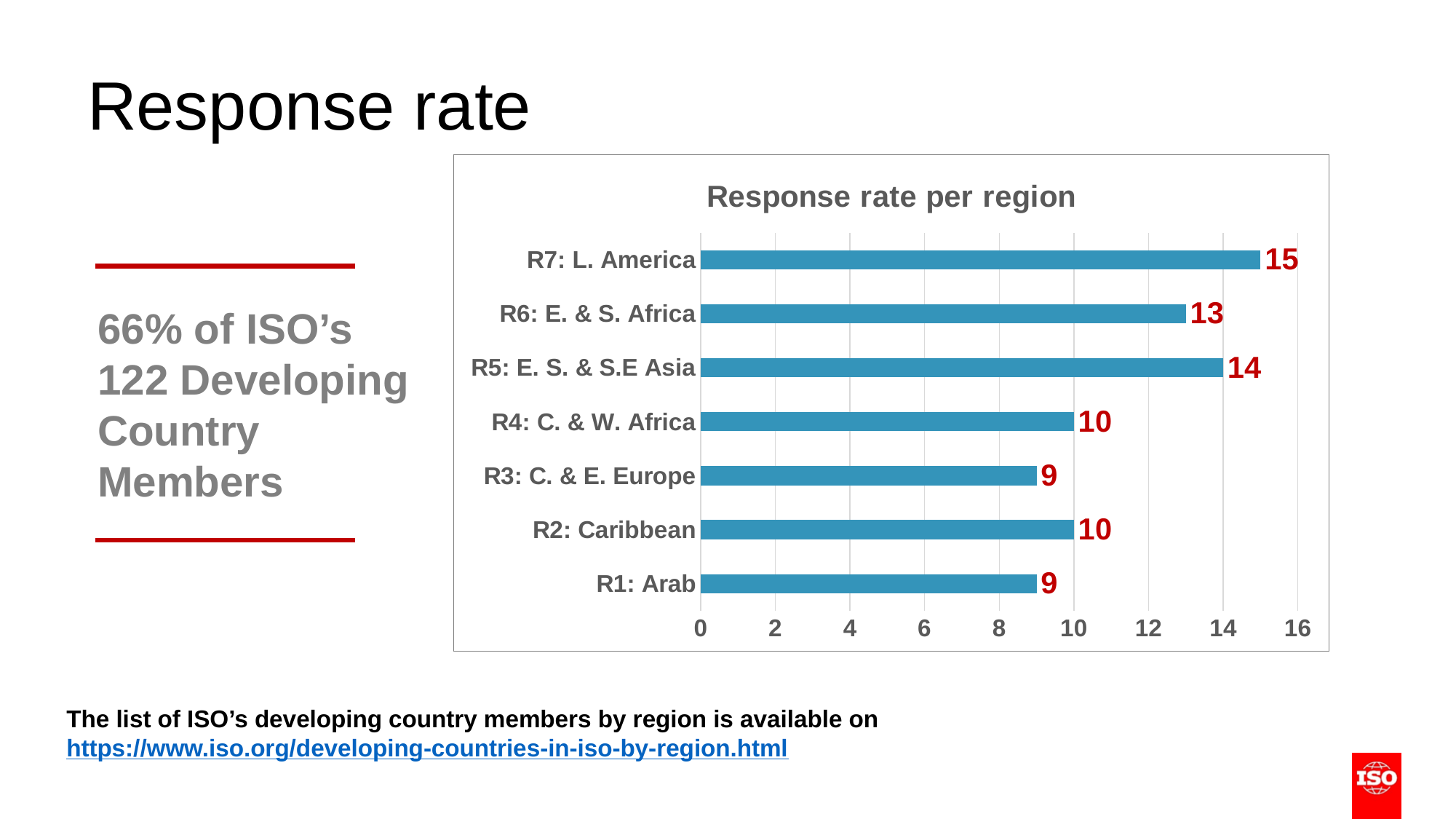
What is the value for R3: C. & E. Europe? 9 What is the maximum value shown on the horizontal axis? 16 Which is larger, the value for R6: E. & S. Africa or the value for R2: Caribbean? R6: E. & S. Africa What kind of chart is shown on the slide? Bar chart How many regions are shown in the chart? 7 What is the value for R6: E. & S. Africa? 13 What is the title of the chart? Response rate per region Which region has the highest value? R7: L. America Is the value for R5: E. S. & S.E Asia greater or less than 12? greater What is the difference between the values for R7: L. America and R1: Arab? 6 What is the difference between the values for R5: E. S. & S.E Asia and R4: C. & W. Africa? 4 What is the value for R7: L. America? 15